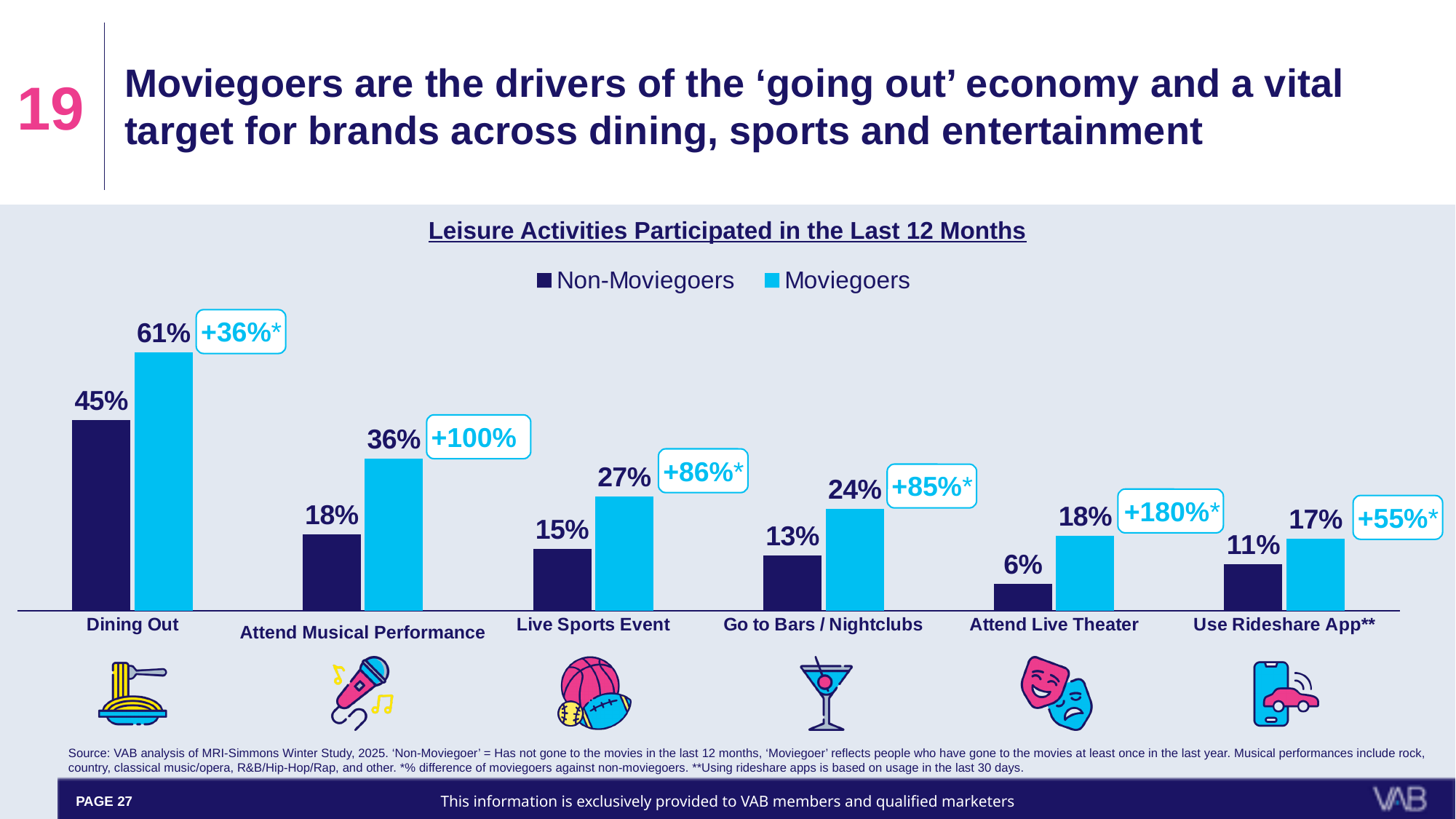
What is the title of the chart? Leisure Activities Participated in the Last 12 Months What is the difference between Moviegoers and Non-Moviegoers for Attend Musical Performance? 18% How many categories are shown on the x axis? 6 What percentage difference is shown in the callout for Attend Live Theater? +180%* Which category has the highest Non-Moviegoers value? Dining Out Which is larger: the Moviegoers value for Go to Bars / Nightclubs or the Moviegoers value for Attend Live Theater? Go to Bars / Nightclubs What is the value for Moviegoers for Dining Out? 61% What is the value for Moviegoers for Live Sports Event? 27% Which category has the lowest Moviegoers value? Use Rideshare App** What kind of chart is shown? Bar chart How many series does the legend list? 2 What is the value for Non-Moviegoers for Attend Live Theater? 6%